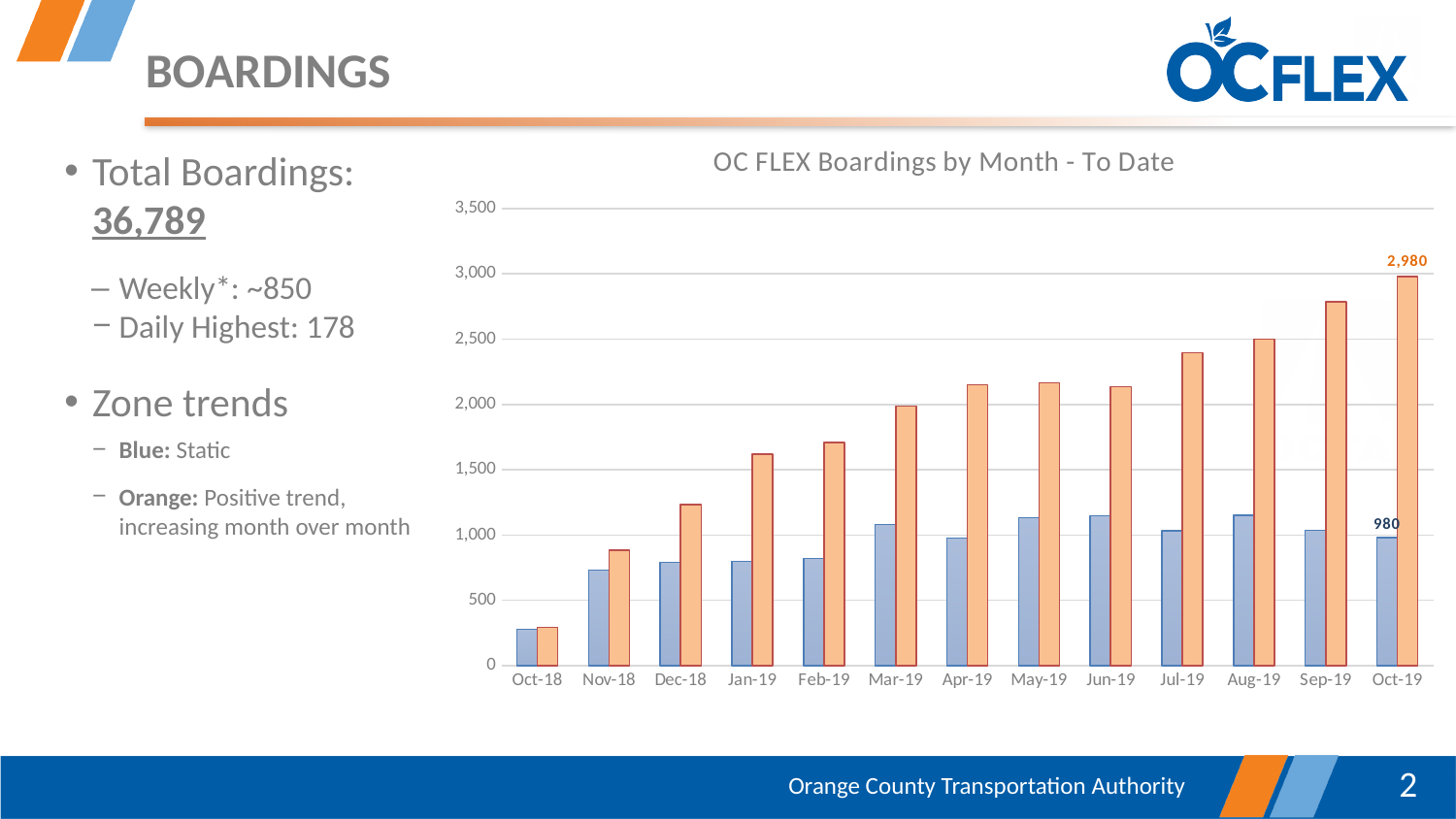
Is the blue bar for Nov-18 greater or less than 1,000? less How many months are shown on the x axis? 13 What is the value of the blue bar for Oct-19? 980 What is the difference between the orange and blue bars for Oct-19? 2,000 Which month has the highest orange bar? Oct-19 What is the title of the chart? OC FLEX Boardings by Month - To Date Which is larger, the orange bar for Sep-19 or the orange bar for Aug-19? Sep-19 What kind of chart is shown on the slide? bar chart What is the value of the orange bar for Oct-19? 2,980 Which month has the lowest orange bar? Oct-18 Is the orange bar for Mar-19 greater or less than 1,500? greater Do the orange bars generally rise or fall from Oct-18 to Oct-19? rise